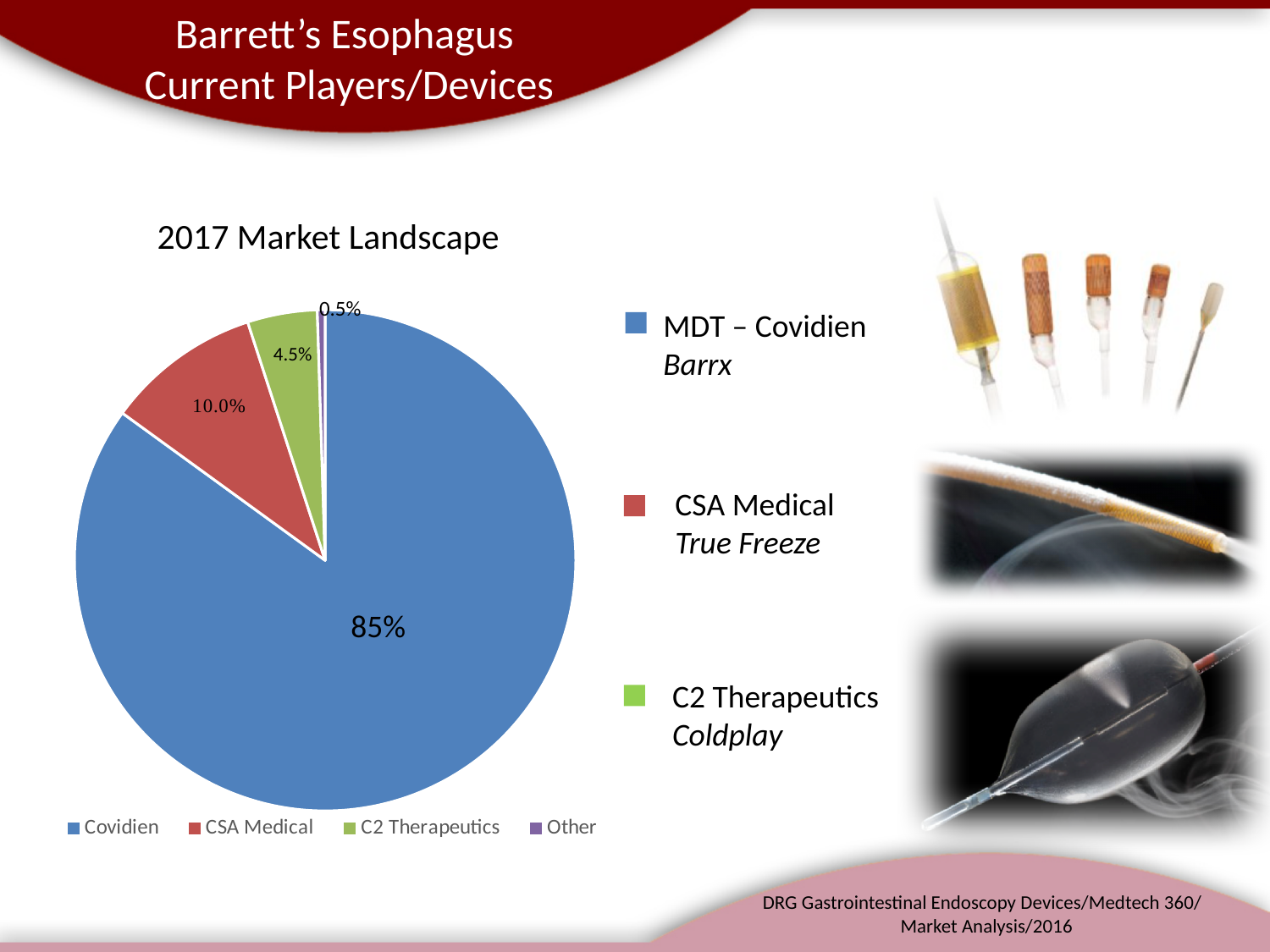
What share of the pie does Covidien hold? 85% How many categories does the legend list? 4 What share of the pie does Other hold? 0.5% What is the difference in percentage points between the CSA Medical share and the C2 Therapeutics share? 5.5 What share of the pie does CSA Medical hold? 10.0% What type of chart is shown on the slide? pie chart What is the title of the chart? 2017 Market Landscape Which is larger, the share for CSA Medical or the share for C2 Therapeutics? CSA Medical Which category has the largest slice of the pie? Covidien Which category has the smallest slice of the pie? Other What colour is the Covidien slice in the pie chart? blue What share of the pie does C2 Therapeutics hold? 4.5%